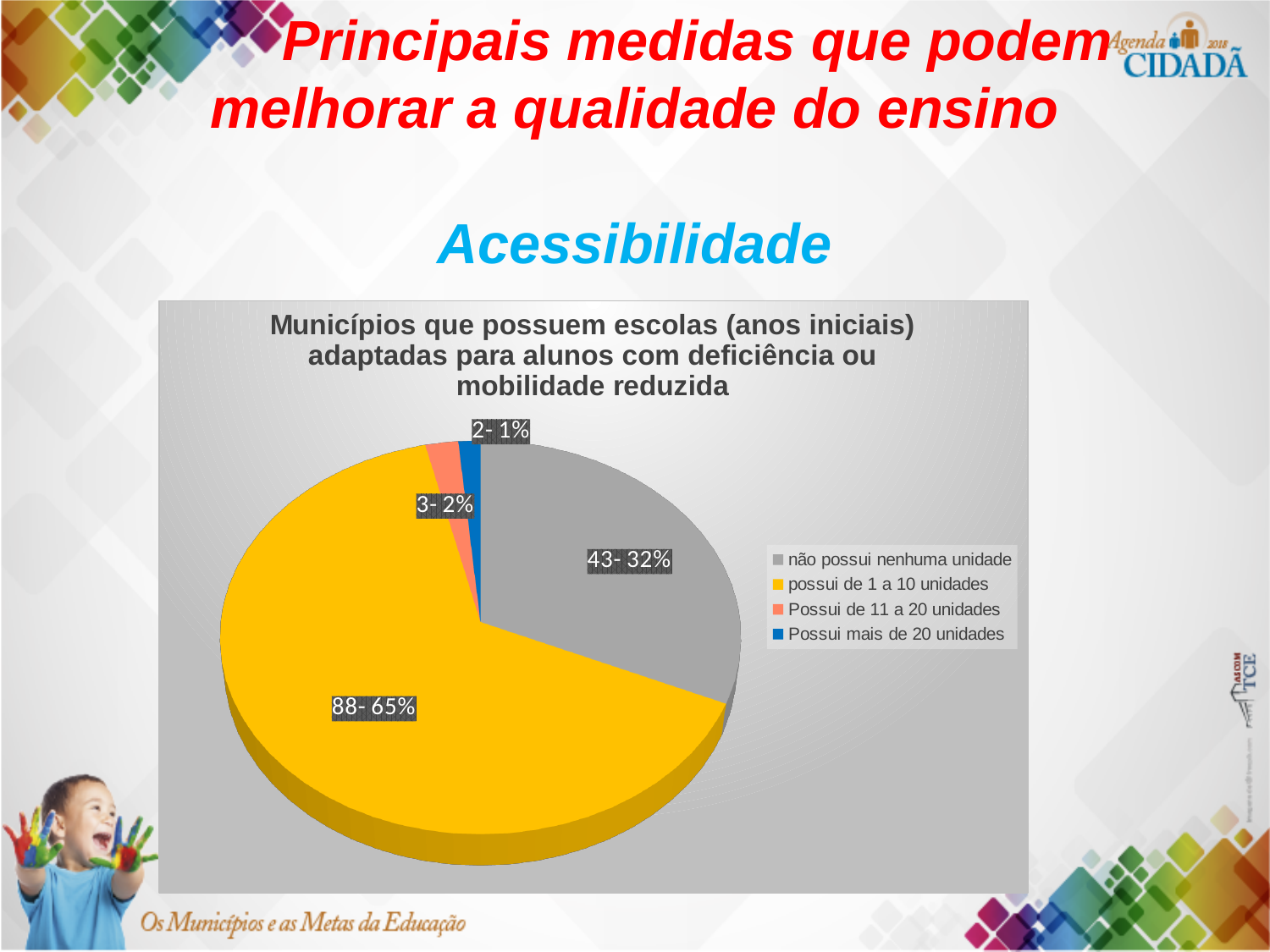
How many entries does the legend of the pie chart list? 4 Which colour represents 'não possui nenhuma unidade' in the pie chart? grey What percentage share does the 'Possui mais de 20 unidades' slice have? 1% What is the difference in number of municipalities between 'possui de 1 a 10 unidades' and 'não possui nenhuma unidade'? 45 What percentage share does the 'não possui nenhuma unidade' slice have? 32% How many municipalities are in the 'Possui de 11 a 20 unidades' slice? 3 What is the title of the pie chart? Municípios que possuem escolas (anos iniciais) adaptadas para alunos com deficiência ou mobilidade reduzida Which category has the smallest slice of the pie? Possui mais de 20 unidades Which category has the largest slice of the pie? possui de 1 a 10 unidades How many municipalities are in the 'possui de 1 a 10 unidades' slice? 88 How many slices does the pie chart have? 4 What kind of chart is shown on the slide? pie chart